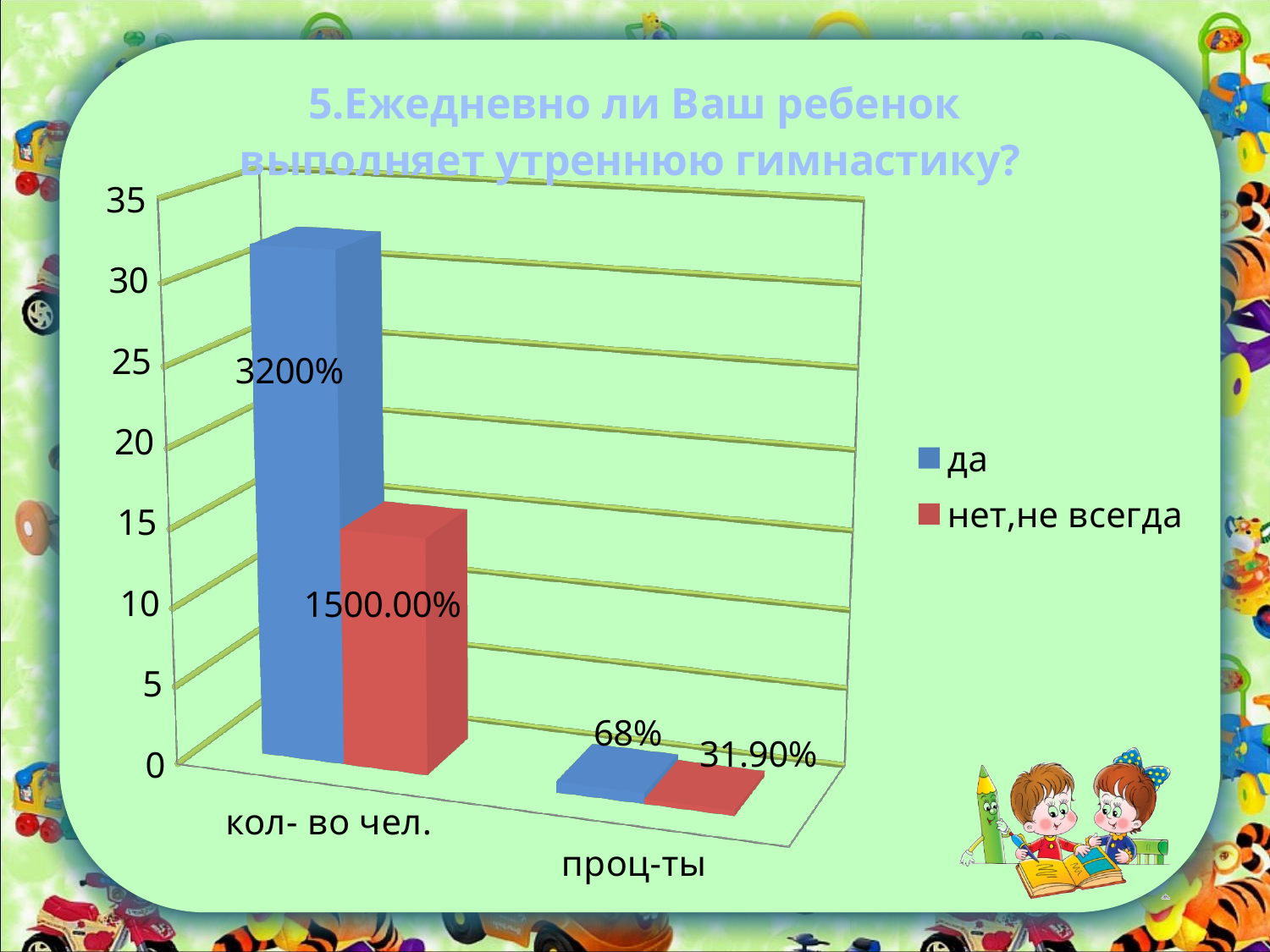
Is the "да" bar for "кол- во чел." greater or less than 30 on the axis? greater Which series has the taller bar in the category "кол- во чел."? да How many series does the legend list? 2 What is the data label on the "нет,не всегда" bar for the category "кол- во чел."? 1500.00% Which series has the taller bar in the category "проц-ты"? да What kind of chart is shown on the slide? bar chart Is the "нет,не всегда" bar for "кол- во чел." greater or less than 20 on the axis? less What is the data label on the "нет,не всегда" bar for the category "проц-ты"? 31.90% What colour is the "нет,не всегда" series in the legend? red How many categories are shown on the x axis? 2 What is the data label on the "да" bar for the category "кол- во чел."? 3200% What is the data label on the "да" bar for the category "проц-ты"? 68%